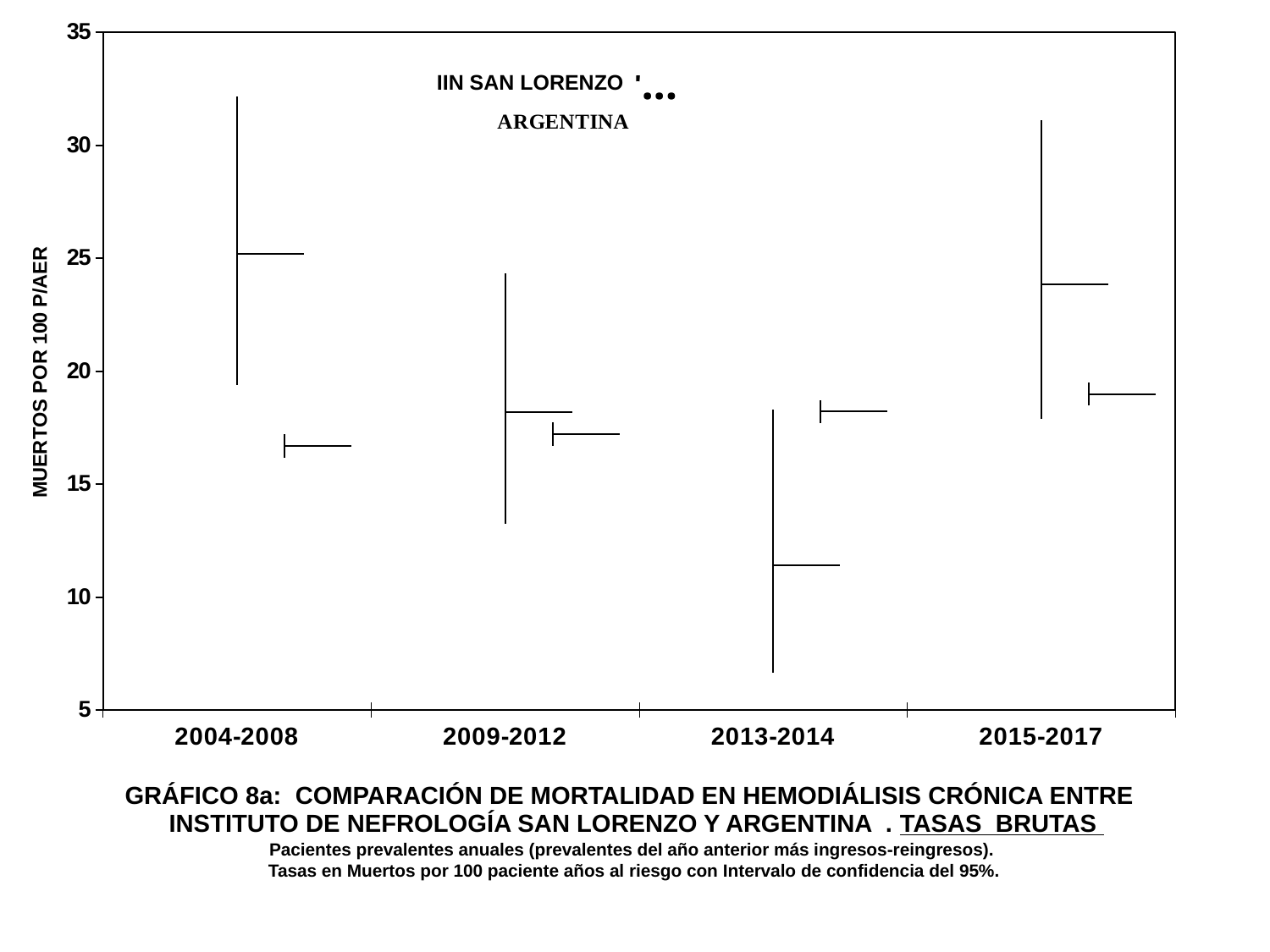
Is the value for IIN San Lorenzo in 2015-2017 greater or less than 20? greater Is the value for IIN San Lorenzo in 2013-2014 greater or less than 15? less Is the value for IIN San Lorenzo in 2004-2008 greater or less than 20? greater In which period is the IIN San Lorenzo value lowest? 2013-2014 How many time periods are shown on the x axis? 4 In 2013-2014, which series has the higher value, IIN San Lorenzo or Argentina? Argentina How many series does the legend list? 2 In 2004-2008, which series has the higher value, IIN San Lorenzo or Argentina? IIN San Lorenzo What is the label of the y axis? MUERTOS POR 100 P/AER In 2015-2017, which series has the higher value, IIN San Lorenzo or Argentina? IIN San Lorenzo